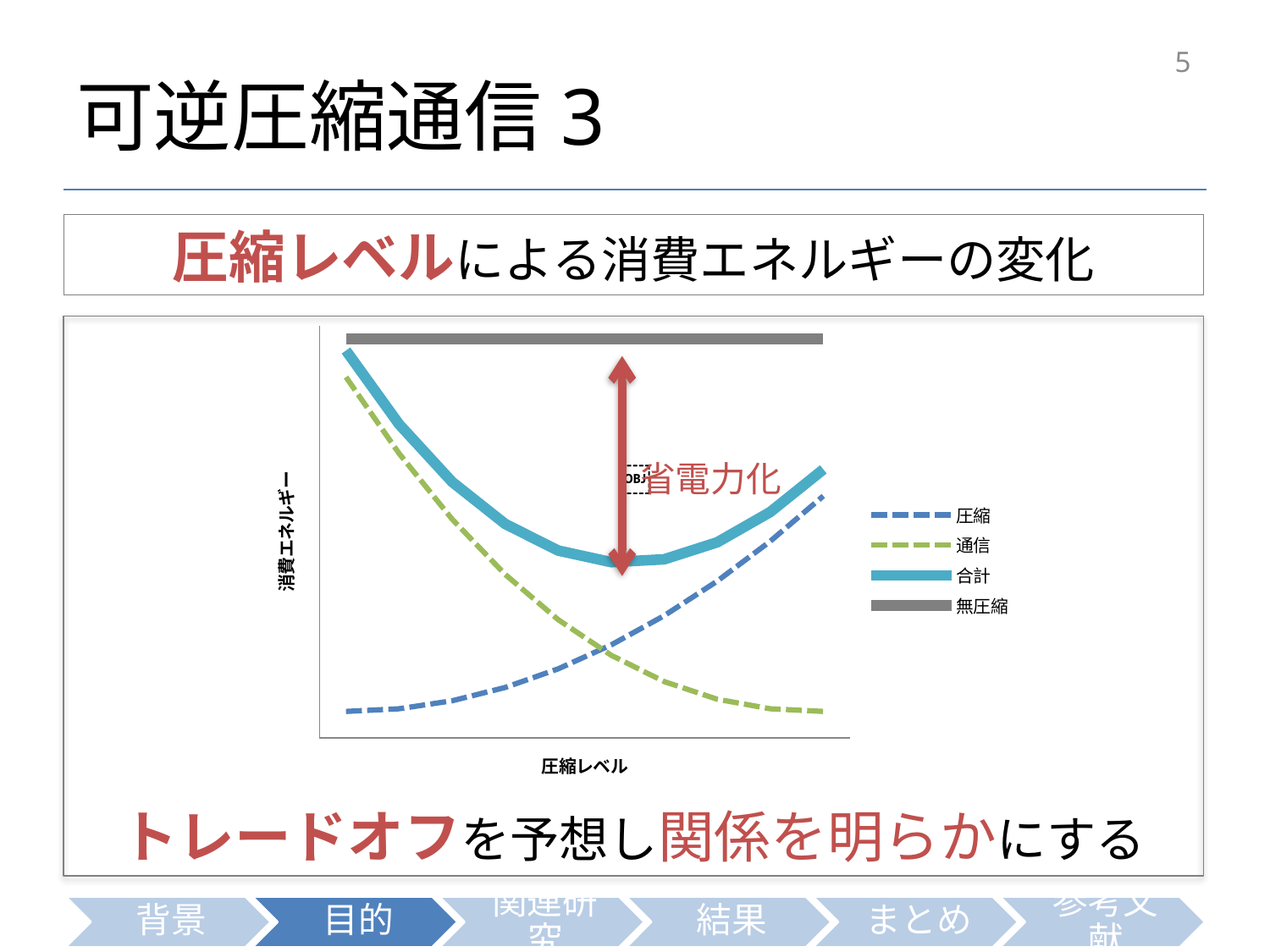
At the left end of the x axis, which is larger: 圧縮 or 通信? 通信 How many series does the legend list? 4 Does the 無圧縮 series rise, fall, or stay flat along the x axis? stays flat Which series is the highest across the whole chart? 無圧縮 At the right end of the x axis, which is larger: 圧縮 or 通信? 圧縮 What are the series names listed in the legend, from top to bottom? 圧縮, 通信, 合計, 無圧縮 Does the 合計 series first fall and then rise, or first rise and then fall, along the x axis? first falls and then rises Does the 通信 series rise or fall as 圧縮レベル increases along the x axis? falls At the right end of the x axis, which series is the lowest? 通信 What kind of chart is shown on the slide? line chart What is the label of the x axis? 圧縮レベル